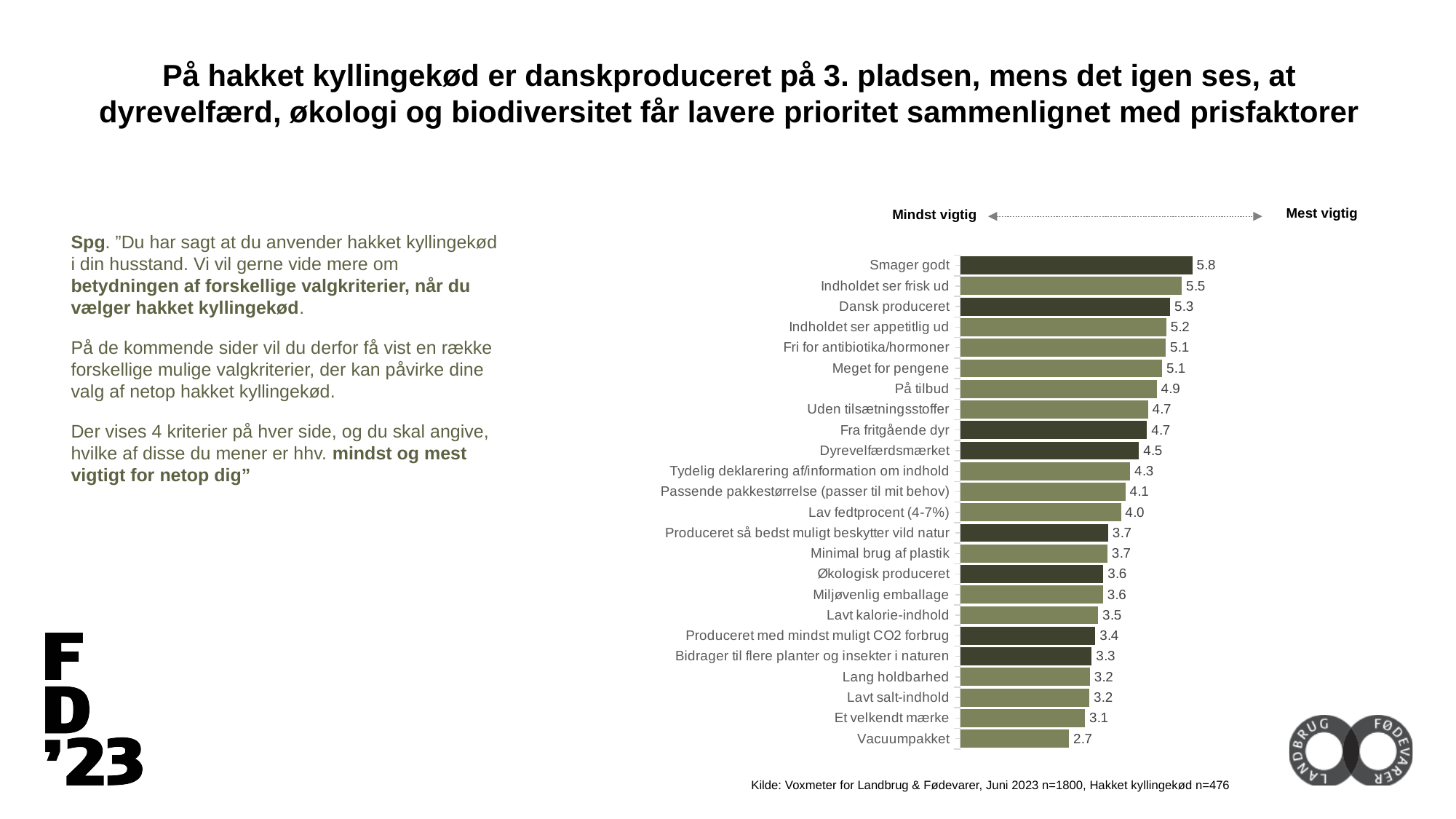
How many categories are shown in the chart? 24 What label appears at the right end of the arrow above the chart? Mest vigtig What is the value for Dansk produceret? 5.3 What is the difference between the values for Dansk produceret and Økologisk produceret? 1.7 What is the difference between the values for Smager godt and Vacuumpakket? 3.1 What is the value for Vacuumpakket? 2.7 Which category has the lowest value? Vacuumpakket Which has a larger value, På tilbud or Lang holdbarhed? På tilbud What kind of chart is shown on the slide? Bar chart What is the value for Økologisk produceret? 3.6 Which category has the highest value? Smager godt What is the value for Dyrevelfærdsmærket? 4.5